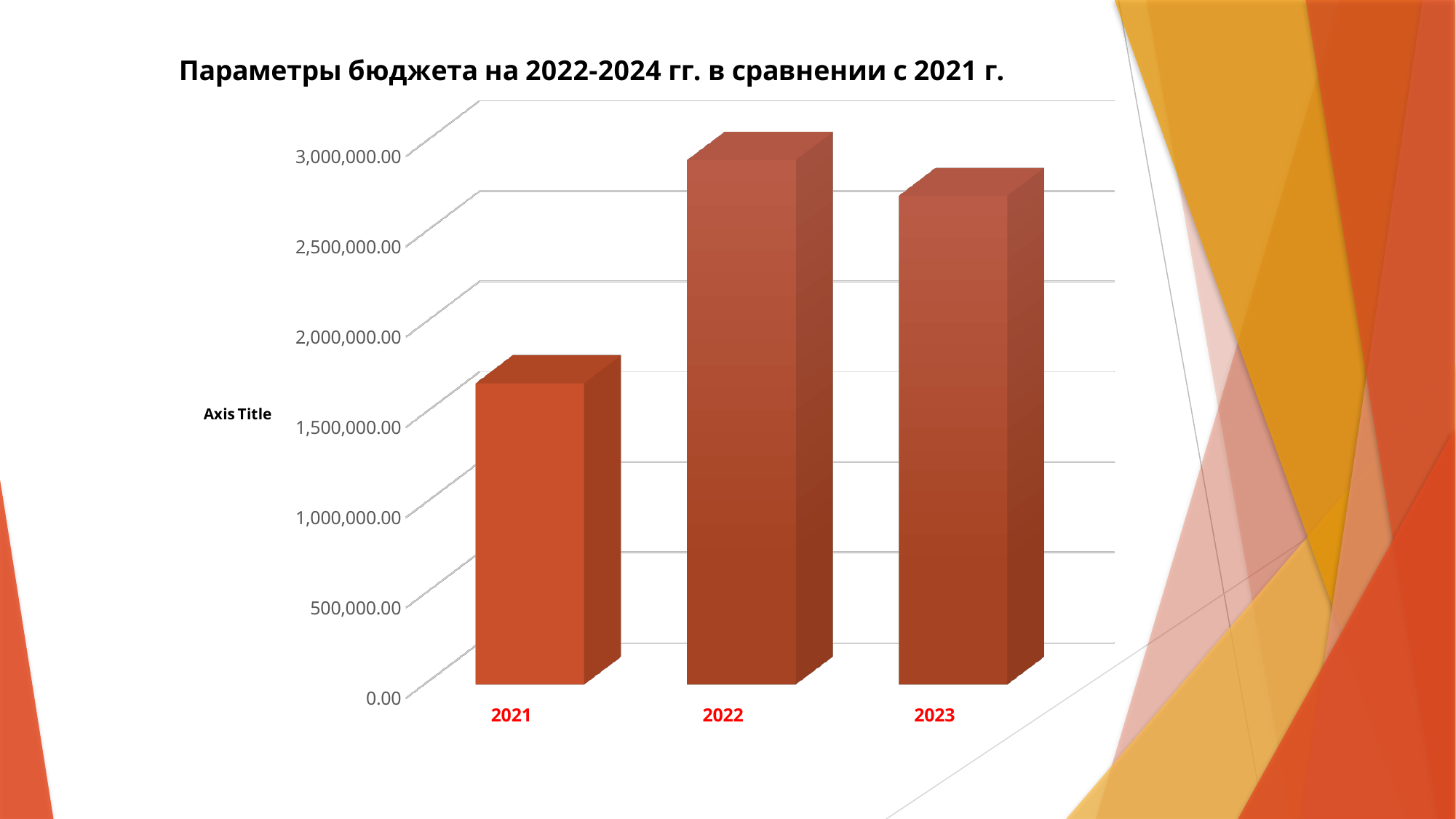
What is the label shown on the vertical axis of the chart? Axis Title Which year has the lowest bar in the chart? 2021 What is the title of the chart? Параметры бюджета на 2022-2024 гг. в сравнении с 2021 г. Which year has the highest bar in the chart? 2022 Is the value for 2023 greater or less than 3,000,000.00? less Which is larger, the value for 2021 or the value for 2023? 2023 Which is larger, the value for 2022 or the value for 2023? 2022 Is the value for 2022 greater or less than 2,500,000.00? greater What kind of chart is shown on the slide? bar chart Is the value for 2021 greater or less than 1,500,000.00? greater How many categories (years) are plotted in the chart? 3